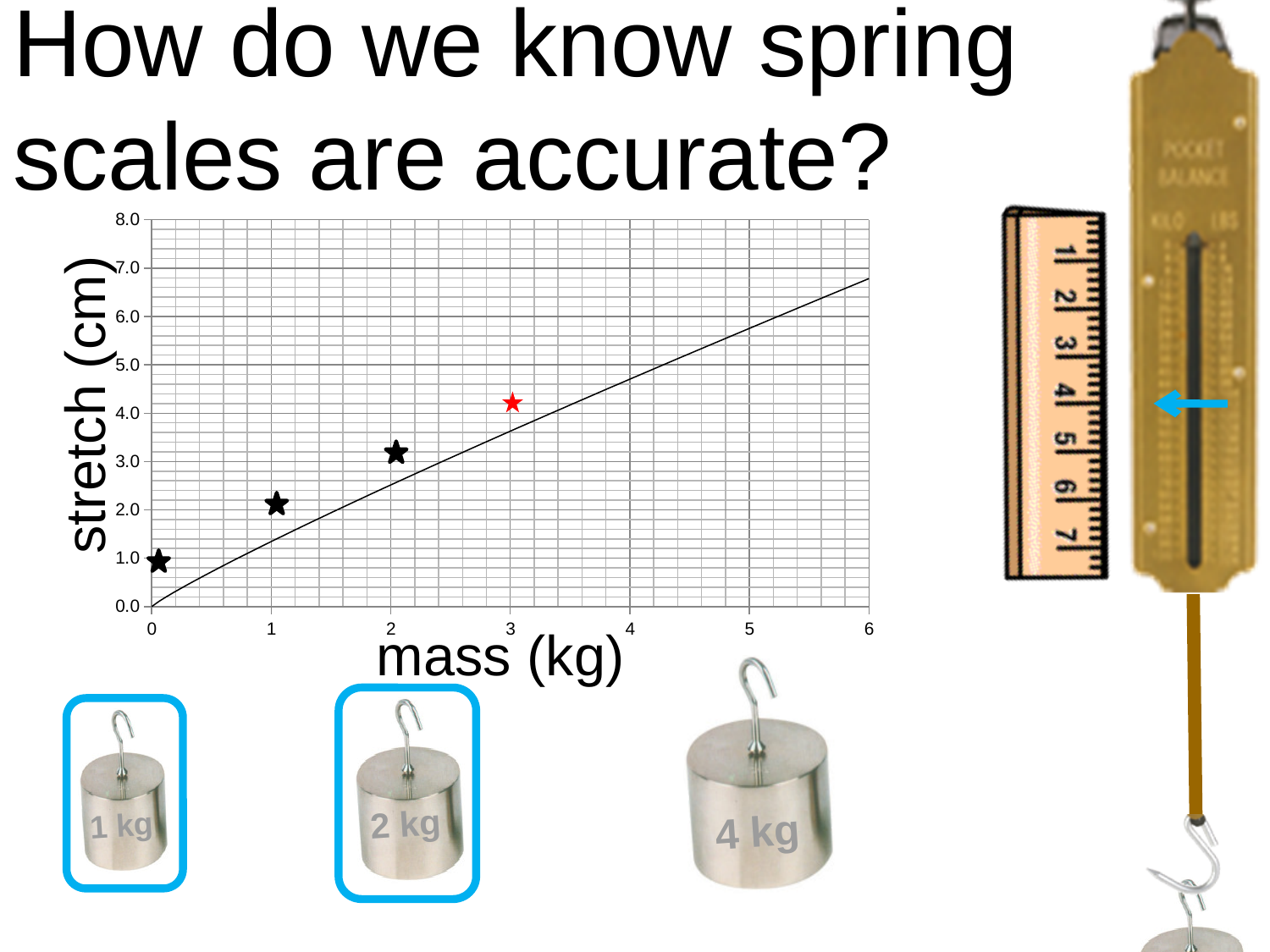
Which has the larger stretch value: the point at 1 kg or the point at 2 kg? 2 kg Do the plotted stretch values rise or fall as mass increases along the x axis? rise Is the stretch value for the point at 0 kg greater or less than 2.0? less Is the stretch value for the point at 2 kg greater or less than 2.0? greater What is the label of the y axis of the chart? stretch (cm) Which plotted mass has the highest stretch value? 3 kg What kind of chart is shown on the slide? scatter chart What is the label of the x axis of the chart? mass (kg) Is the stretch value for the point at 3 kg greater or less than 3.0? greater How many star data points are plotted on the chart? 4 Which plotted mass has the lowest stretch value? 0 kg